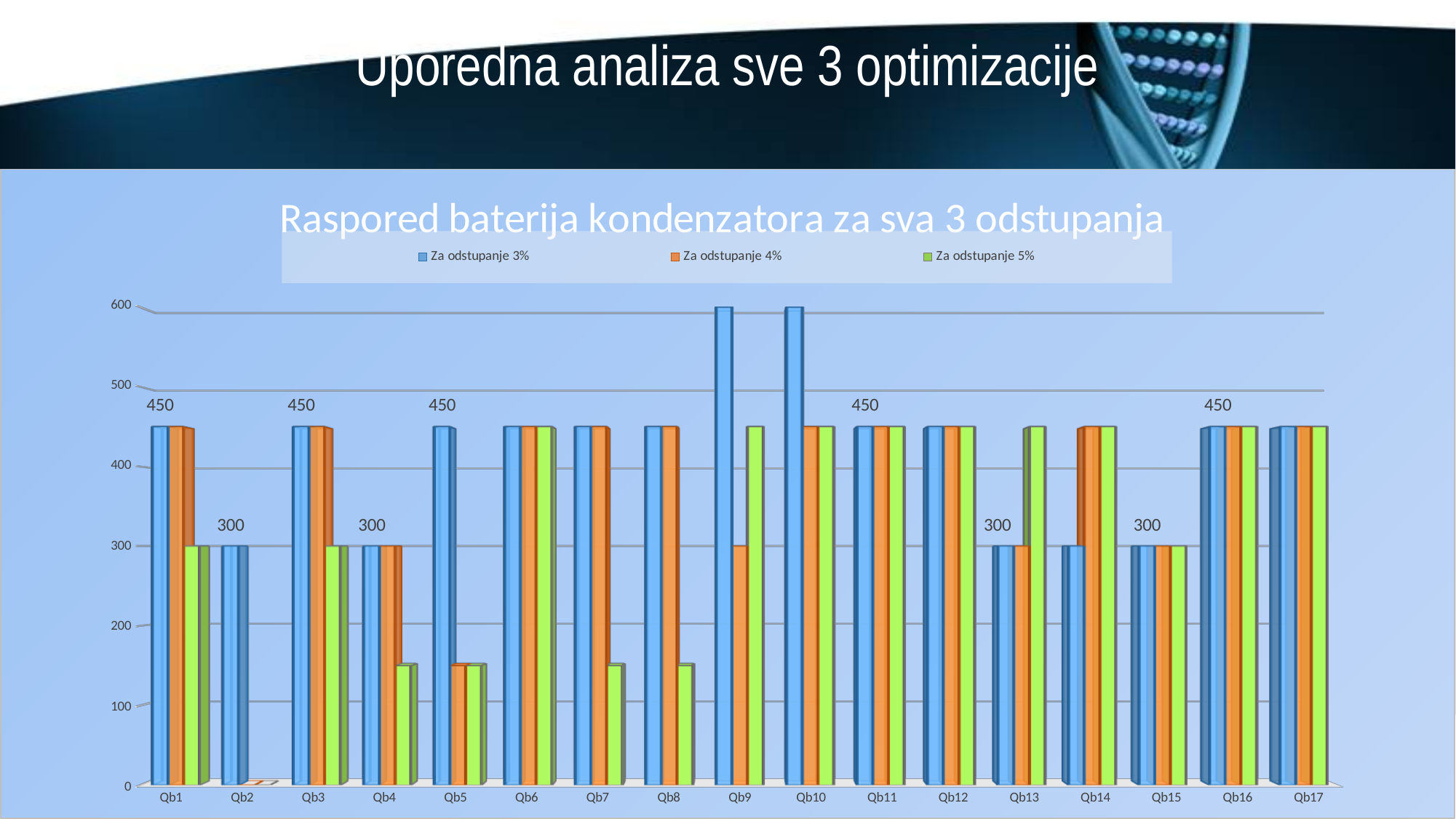
What is the title of the chart? Raspored baterija kondenzatora za sva 3 odstupanja How many series does the legend list? 3 Which is larger in the 'Za odstupanje 3%' series, Qb1 or Qb2? Qb1 Is the value for Qb9 in the 'Za odstupanje 3%' series greater or less than 500? greater What is the value for Qb1 in the 'Za odstupanje 3%' series? 450 What is the value for Qb13 in the 'Za odstupanje 3%' series? 300 What kind of chart is shown on the slide? bar chart How many categories are shown on the x axis? 17 What is the value for Qb2 in the 'Za odstupanje 3%' series? 300 What is the difference between the 'Za odstupanje 3%' values for Qb1 and Qb2? 150 What is the value for Qb16 in the 'Za odstupanje 3%' series? 450 Is the value for Qb5 in the 'Za odstupanje 4%' series greater or less than 200? less